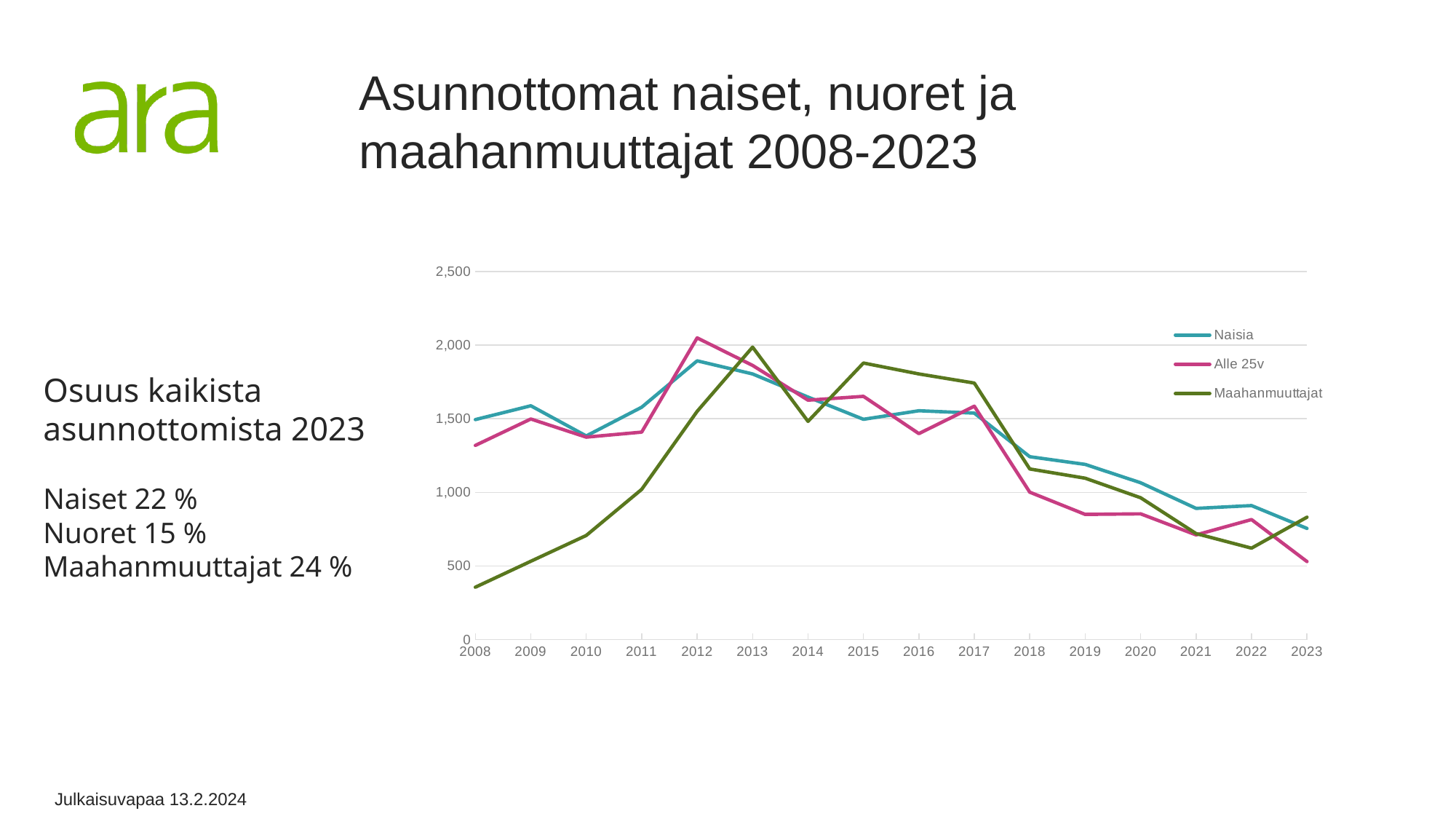
How many series does the chart's legend list? 3 In which year is the Maahanmuuttajat series at its lowest value? 2008 In 2008, which series has the larger value, Naisia or Maahanmuuttajat? Naisia Is the value for Maahanmuuttajat in 2008 greater or less than 500? less Is the value for Naisia in 2018 greater or less than 1,000? greater In 2023, which series has the larger value, Maahanmuuttajat or Alle 25v? Maahanmuuttajat How many years are plotted along the x axis of the chart? 16 Does the Naisia series rise or fall between 2012 and 2023? fall Is the value for Alle 25v in 2019 greater or less than 1,000? less What kind of chart is shown on the slide? line chart Which series are listed in the chart's legend? Naisia, Alle 25v, Maahanmuuttajat In which year does the Alle 25v series reach its highest value? 2012